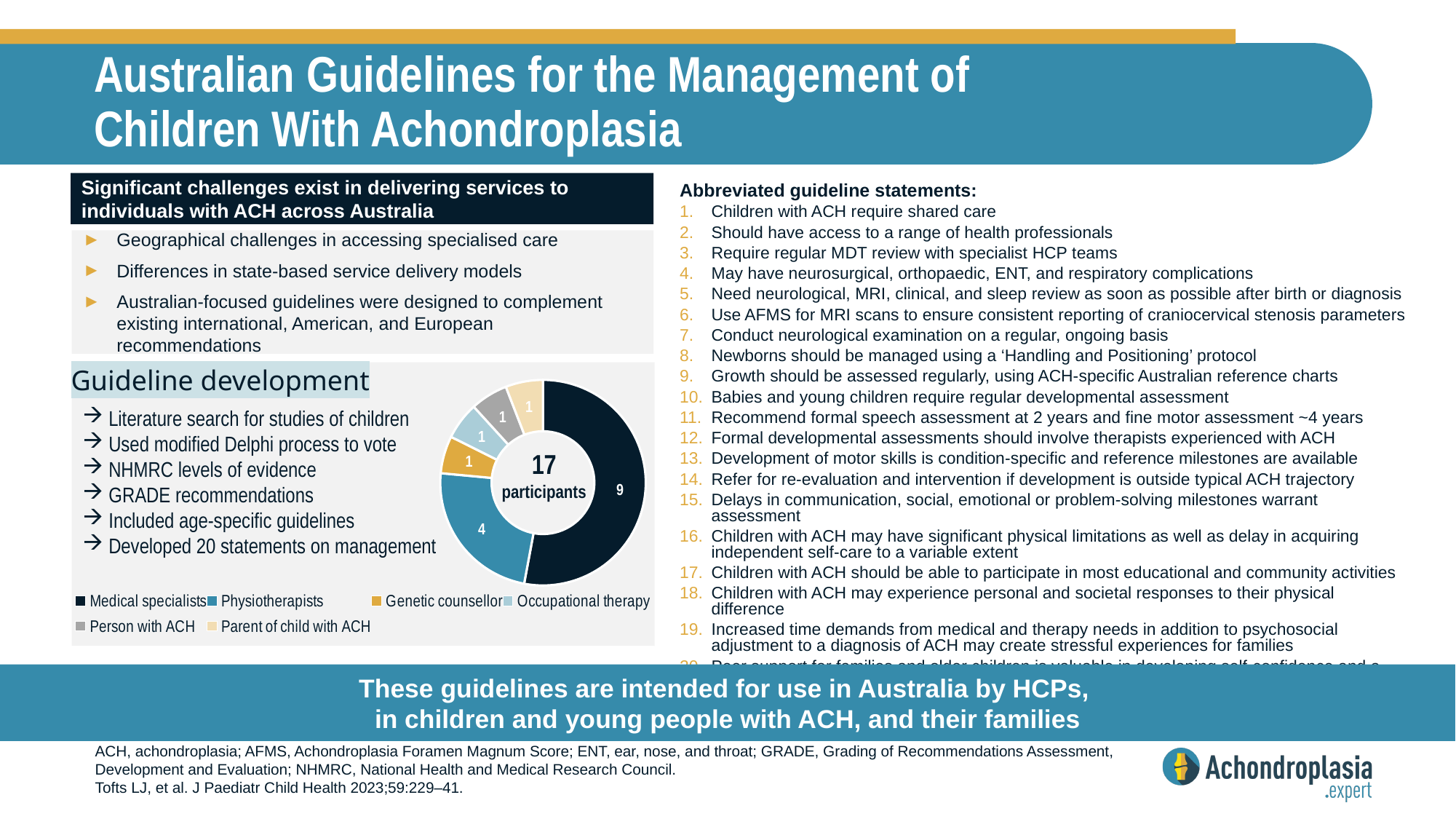
How many groups in the donut chart have exactly 1 participant? 4 What share of the 17 participants are Medical specialists, according to the donut chart? 9/17 How many Genetic counsellors are shown in the donut chart? 1 Which group has the largest slice in the donut chart? Medical specialists How many categories does the legend of the donut chart list? 6 How many Physiotherapists are shown in the donut chart? 4 What kind of chart is shown on the slide? Donut (pie) chart Which legend entry in the donut chart is shown in gold/orange? Genetic counsellor Which is larger in the donut chart: Physiotherapists or Occupational therapy? Physiotherapists What is the difference between the number of Medical specialists and Physiotherapists in the donut chart? 5 How many Medical specialists are shown in the donut chart? 9 How many participants does the centre of the donut chart state? 17 participants